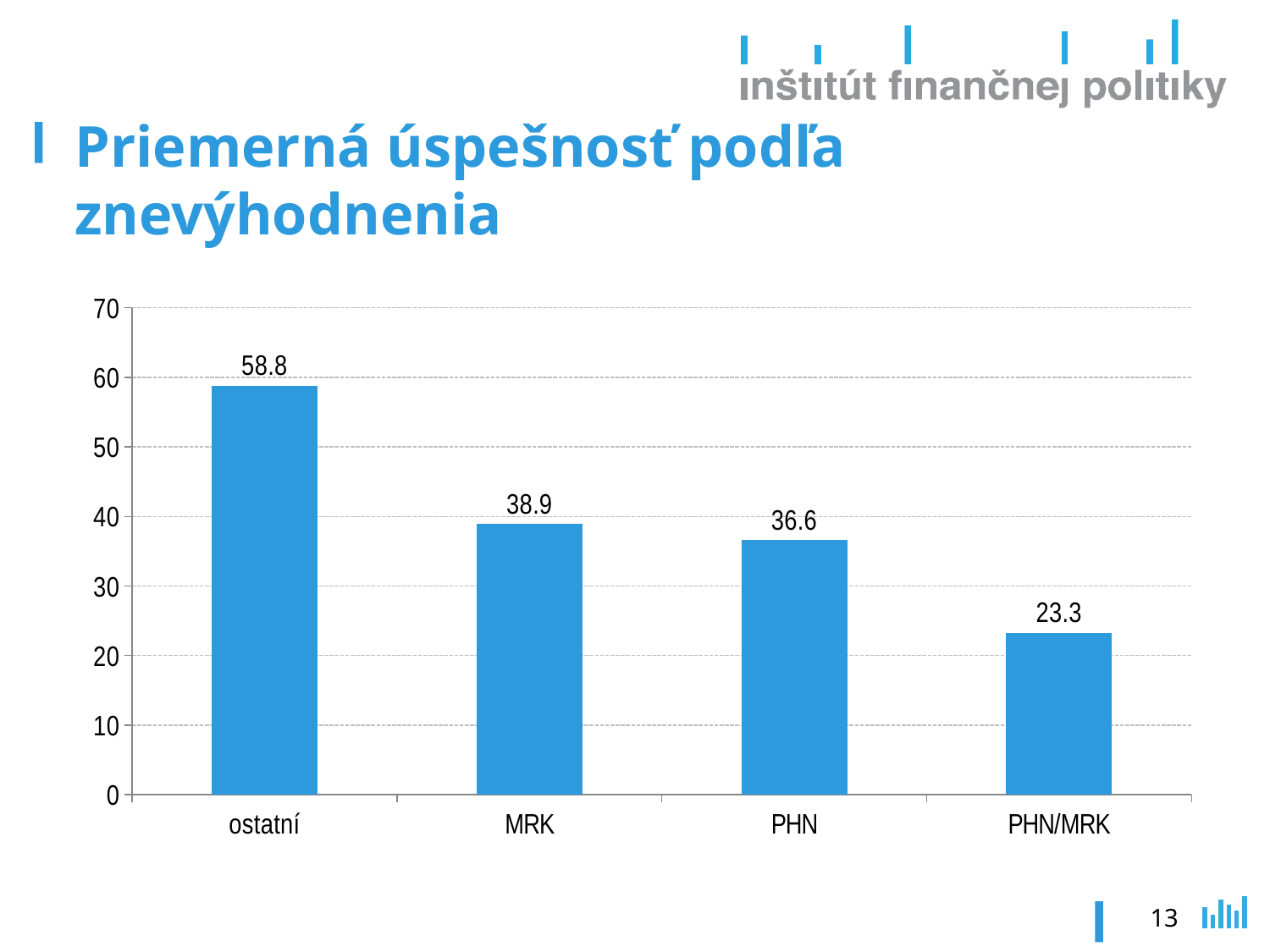
What is the difference between the values for ostatní and PHN/MRK? 35.5 Is the value for PHN/MRK greater or less than 30? less What is the value for PHN/MRK? 23.3 What is the difference between the values for MRK and PHN? 2.3 Which category has the lowest value? PHN/MRK What kind of chart is shown on the slide? bar chart What is the value for ostatní? 58.8 Which is larger, the value for MRK or the value for PHN? MRK What is the value for MRK? 38.9 What is the value for PHN? 36.6 Which category has the highest value? ostatní How many categories are shown on the x axis? 4